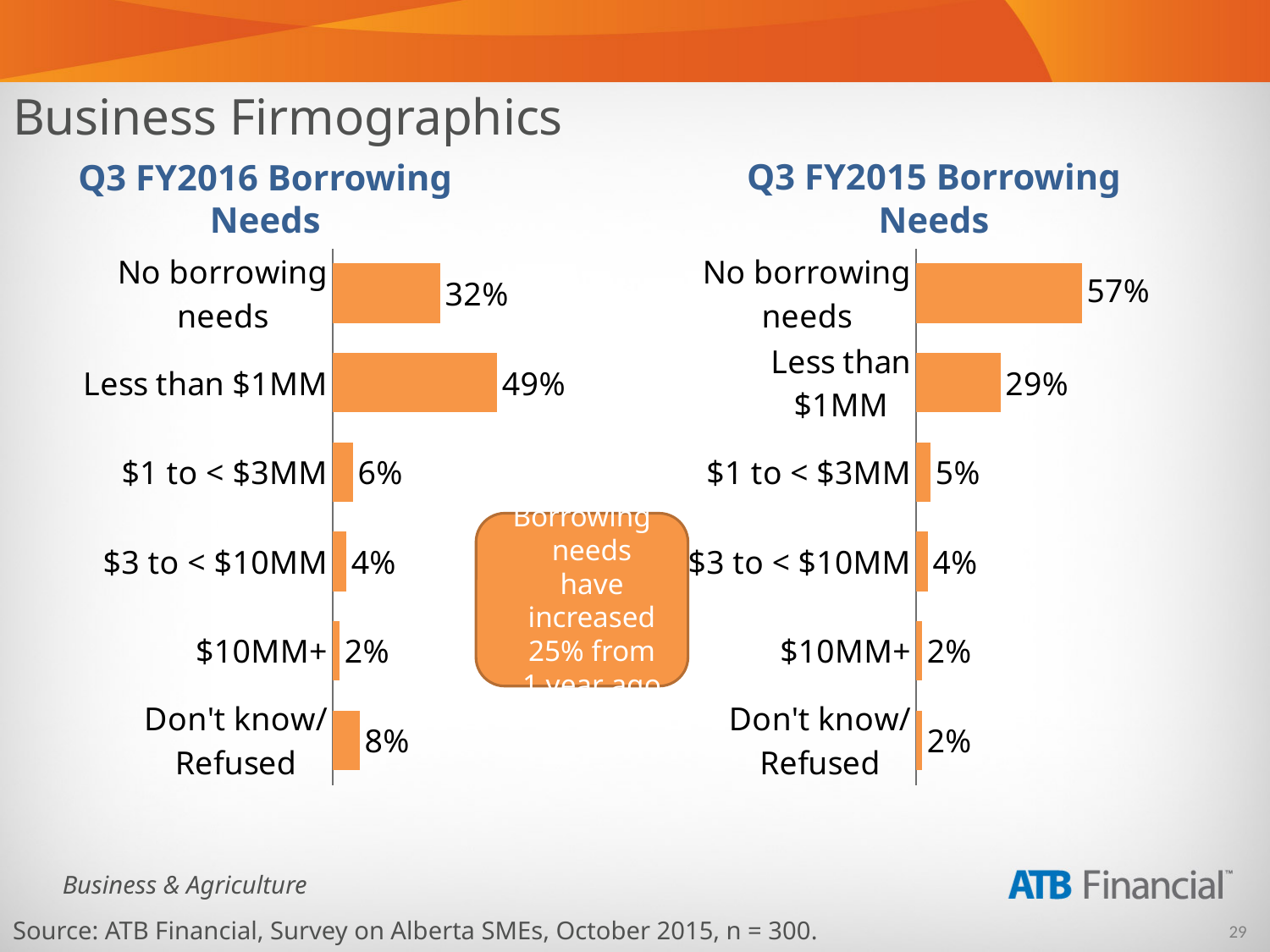
What type of chart is the Q3 FY2015 Borrowing Needs chart? Bar chart In the Q3 FY2016 Borrowing Needs chart, what is the difference between Less than $1MM and No borrowing needs? 17% How many categories does the Q3 FY2016 Borrowing Needs chart show? 6 In the Q3 FY2015 Borrowing Needs chart, what is the difference between No borrowing needs and Less than $1MM? 28% In the Q3 FY2016 Borrowing Needs chart, what is the value for Don't know/Refused? 8% In the Q3 FY2015 Borrowing Needs chart, which category has the highest value? No borrowing needs In the Q3 FY2015 Borrowing Needs chart, what is the value for No borrowing needs? 57% In the Q3 FY2016 Borrowing Needs chart, which category has the highest value? Less than $1MM Which is larger: No borrowing needs in the Q3 FY2016 chart or No borrowing needs in the Q3 FY2015 chart? Q3 FY2015 In the Q3 FY2015 Borrowing Needs chart, what is the value for $1 to < $3MM? 5% In the Q3 FY2016 Borrowing Needs chart, which category has the lowest value? $10MM+ In the Q3 FY2016 Borrowing Needs chart, what is the value for Less than $1MM? 49%